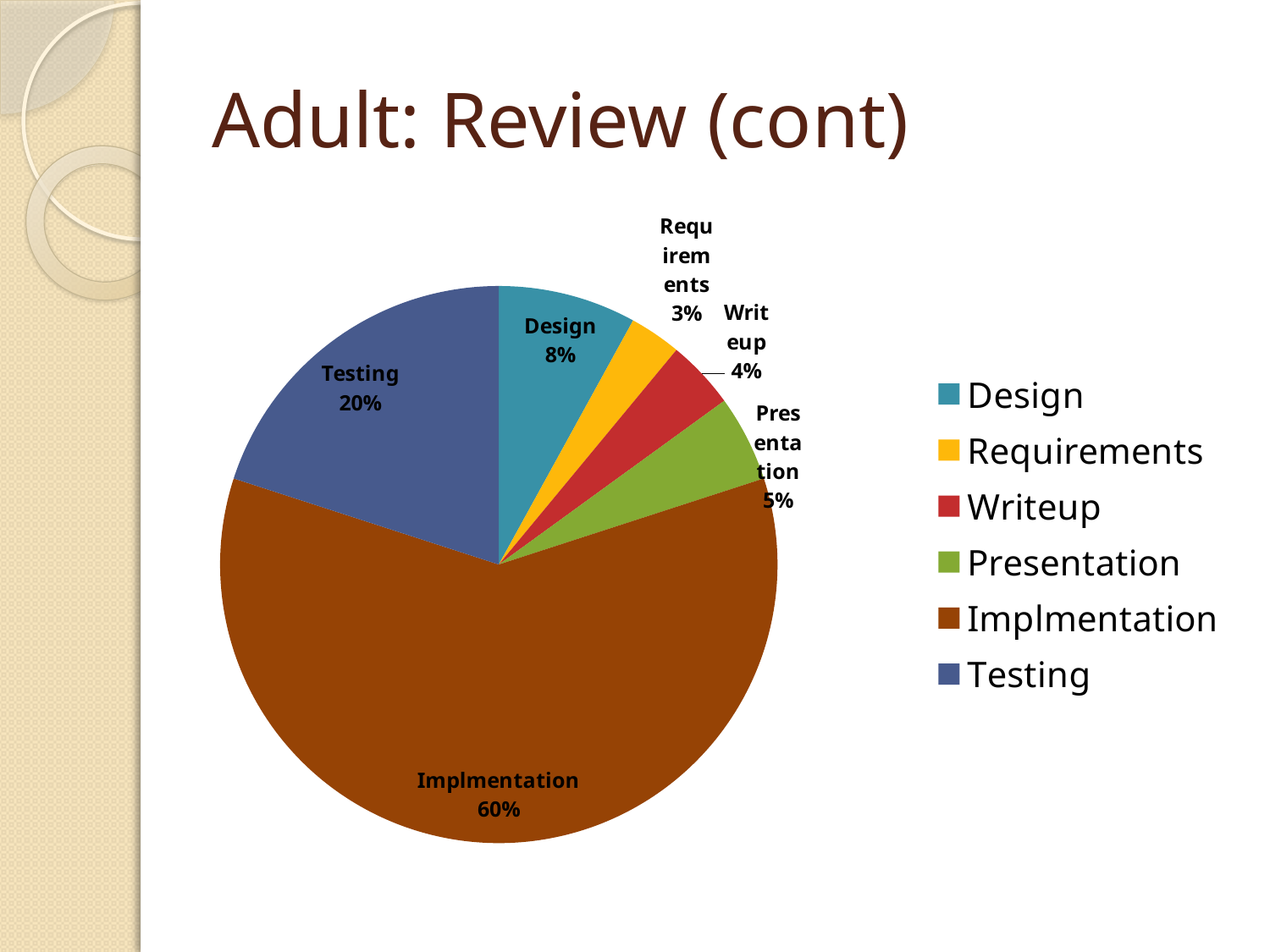
Which slice is the largest? Implmentation What is the difference in percentage points between Implmentation and Testing? 40 What percentage of the pie is Requirements? 3% What kind of chart is shown on the slide? pie chart Which slice is the smallest? Requirements Which is larger, Design or Presentation? Design What percentage of the pie is Design? 8% What percentage of the pie is Testing? 20% What percentage of the pie is Implmentation? 60% What percentage of the pie is Writeup? 4% What percentage of the pie is Presentation? 5% How many entries does the legend list? 6